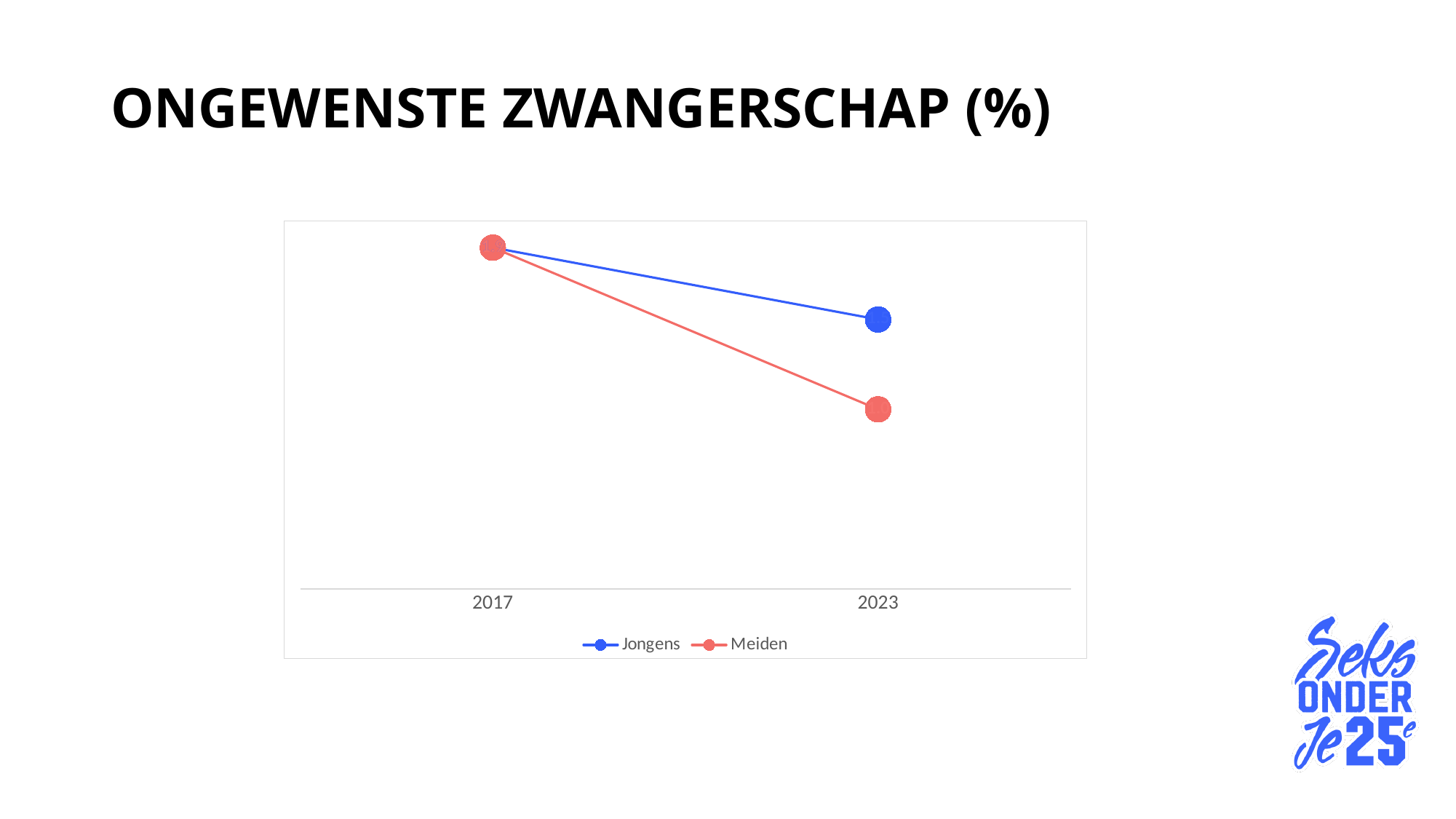
In 2023, which series has the higher value, Jongens or Meiden? Jongens Which series are listed in the legend? Jongens and Meiden What kind of chart is shown on the slide? line chart Does the value for Meiden rise or fall from 2017 to 2023? fall Which series shows the larger decrease between 2017 and 2023? Meiden Which years are shown on the x axis? 2017 and 2023 How many series does the legend list? 2 Does the value for Jongens rise or fall from 2017 to 2023? fall How many years are shown on the x axis? 2 What is the title of the slide? ONGEWENSTE ZWANGERSCHAP (%)